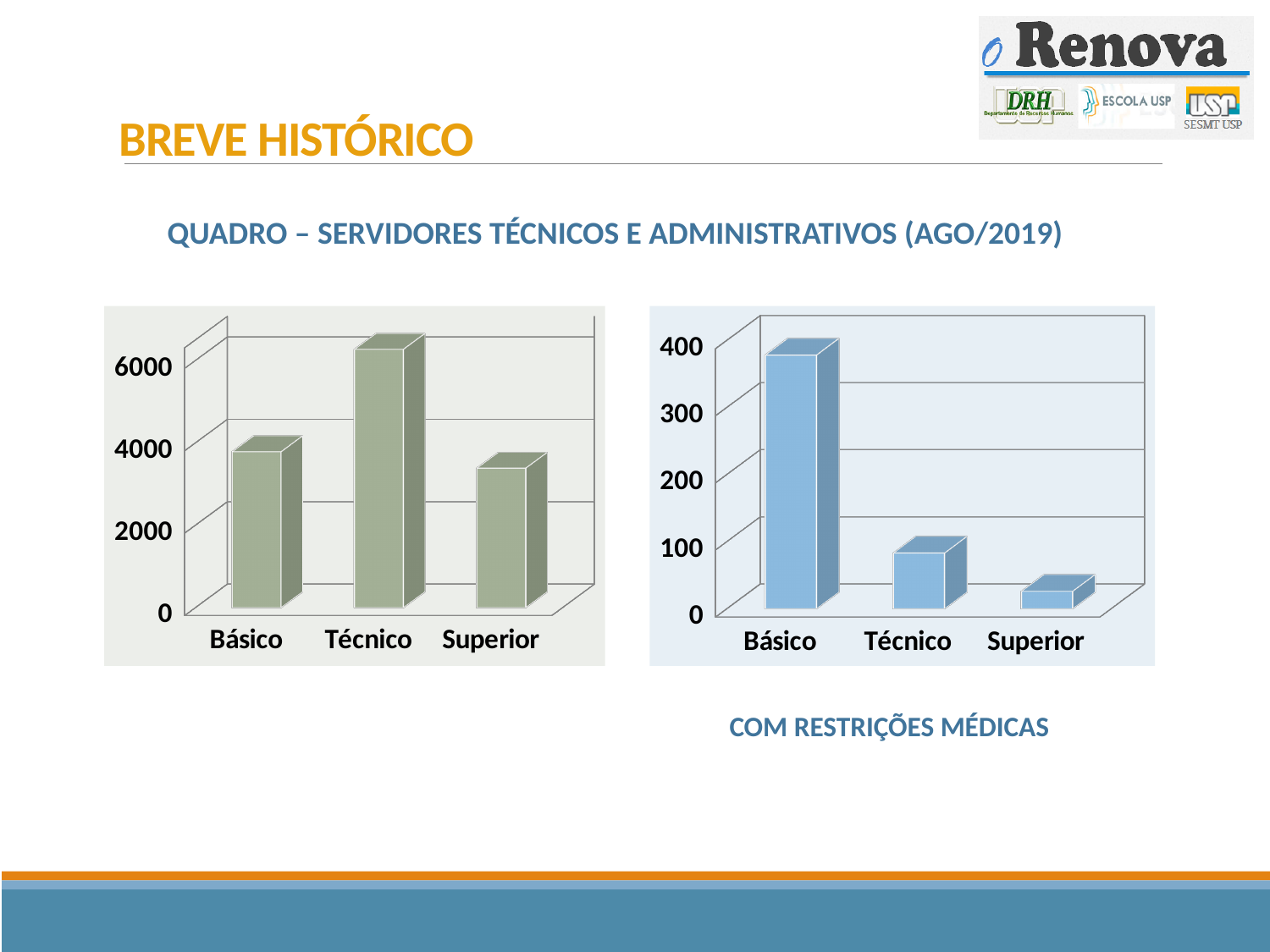
In the right chart (COM RESTRIÇÕES MÉDICAS), is the value for Superior greater or less than 100? less In the left chart, is the value for Superior greater or less than 2000? greater In the right chart (COM RESTRIÇÕES MÉDICAS), is the value for Básico greater or less than 300? greater In the right chart (COM RESTRIÇÕES MÉDICAS), which category has the highest value? Básico How many categories are shown on the x axis of the left chart? 3 In the right chart (COM RESTRIÇÕES MÉDICAS), which is larger, the value for Básico or the value for Técnico? Básico What kind of chart is the right chart (COM RESTRIÇÕES MÉDICAS)? bar chart In the left chart, which category has the highest value? Técnico What kind of chart is the left chart on the slide? bar chart In the right chart (COM RESTRIÇÕES MÉDICAS), which category has the lowest value? Superior